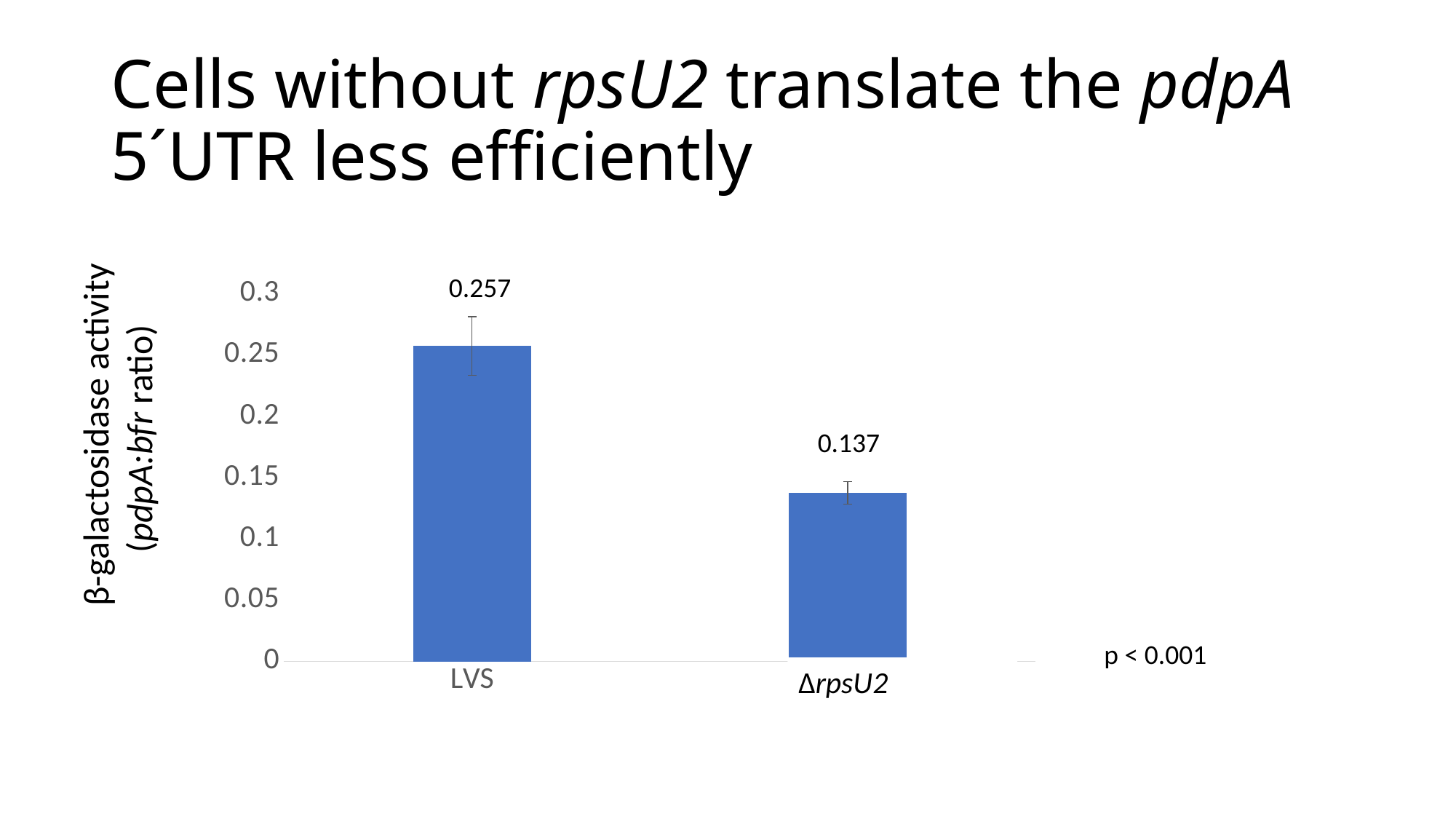
What p-value is stated next to the chart? p < 0.001 Which category has the highest β-galactosidase activity? LVS What kind of chart is shown on the slide? bar chart Which is larger, the value for LVS or the value for ΔrpsU2? LVS What is the label of the y axis? β-galactosidase activity (pdpA:bfr ratio) Is the value for LVS greater or less than 0.2? greater How many categories are shown on the x axis? 2 What is the β-galactosidase activity value for ΔrpsU2? 0.137 What is the β-galactosidase activity value for LVS? 0.257 Is the value for ΔrpsU2 greater or less than 0.15? less What is the difference between the LVS and ΔrpsU2 values? 0.120 Which category has the lowest β-galactosidase activity? ΔrpsU2